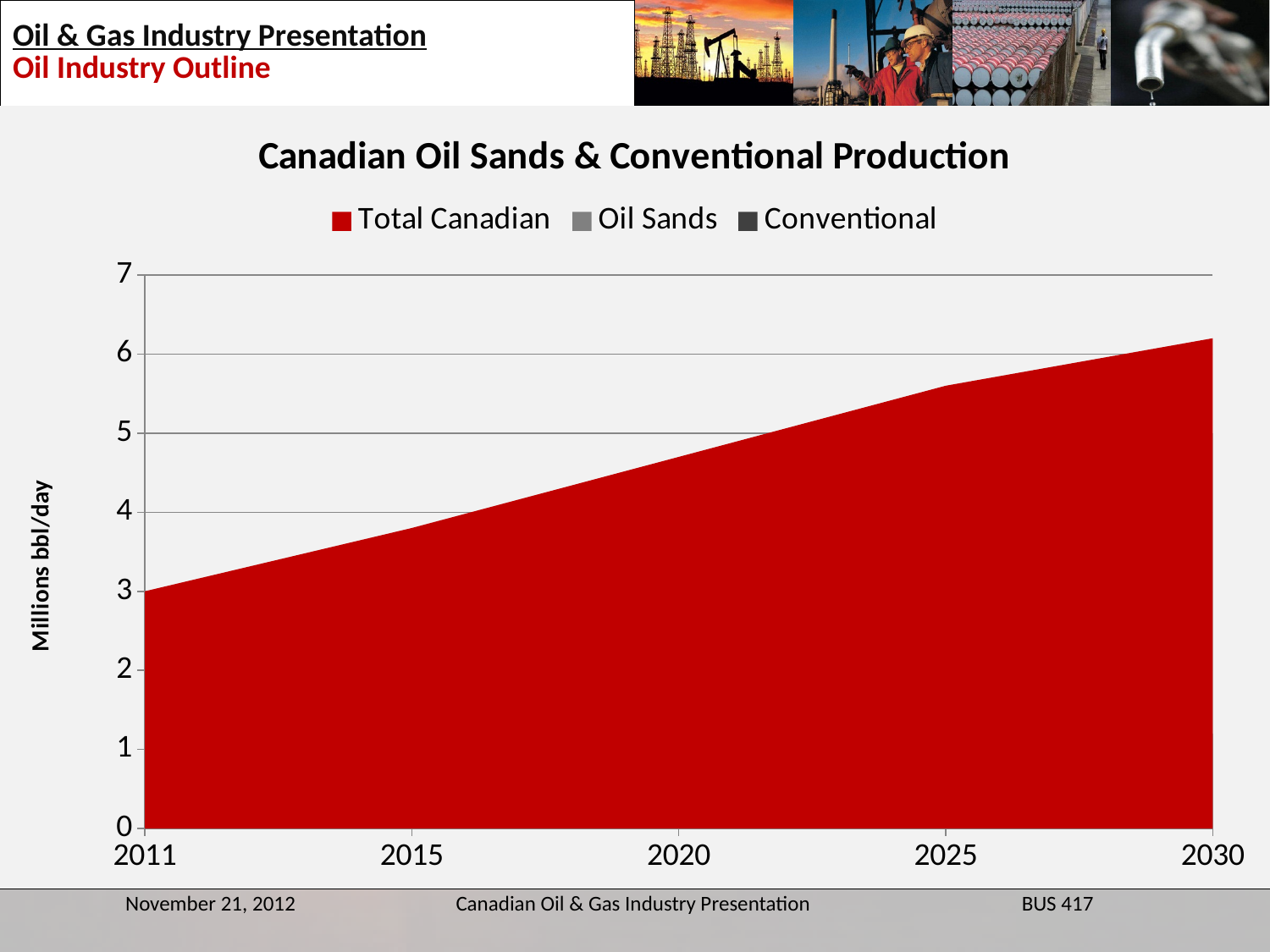
How many series does the legend list? 3 What kind of chart is shown on the slide? area chart Is the Total Canadian value for 2030 greater or less than 6? greater What is the title of the chart? Canadian Oil Sands & Conventional Production Is the Total Canadian value for 2011 greater or less than 4? less Does the Total Canadian production rise or fall from 2011 to 2030? rise Which year shown on the x axis has the lowest Total Canadian production? 2011 What is the label on the vertical axis? Millions bbl/day Is the Total Canadian value for 2020 greater or less than 5? less Which year shown on the x axis has the highest Total Canadian production? 2030